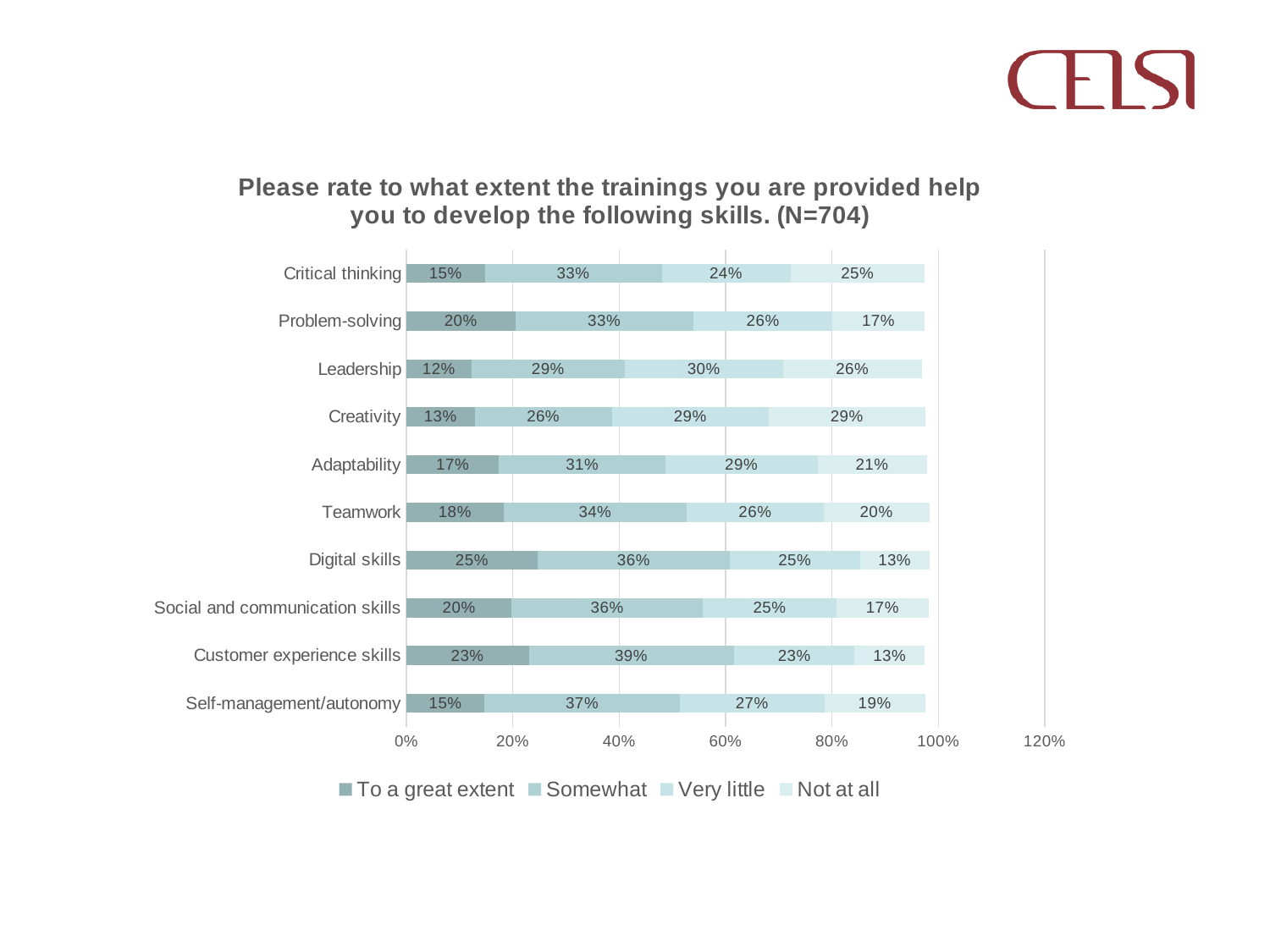
How many skill categories are plotted on the chart? 10 Which skill has the lowest 'To a great extent' value? Leadership What is the 'To a great extent' value for Digital skills? 25% How many series does the legend list? 4 What kind of chart is shown on the slide? Stacked bar chart Which skill has the highest 'To a great extent' value? Digital skills What is the 'Very little' value for Self-management/autonomy? 27% Which is larger: the 'Not at all' value for Critical thinking or for Problem-solving? Critical thinking What is the 'Somewhat' value for Customer experience skills? 39% Which skill has the highest 'Somewhat' value? Customer experience skills What is the 'Not at all' value for Leadership? 26% What is the difference between the 'To a great extent' values for Digital skills and Leadership? 13 percentage points